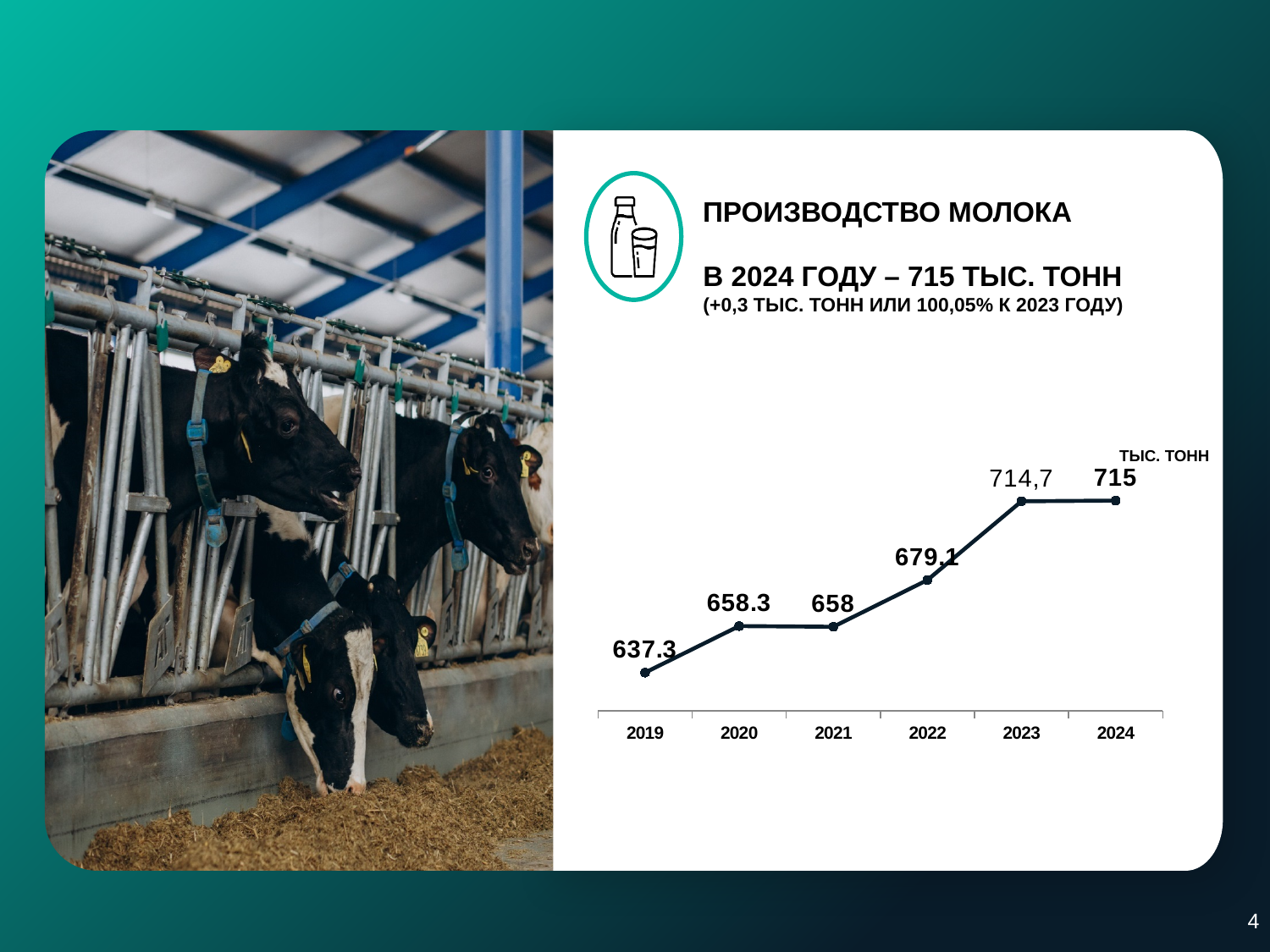
Do the values generally rise or fall from 2019 to 2024? rise Which year has the lowest value? 2019 What is the value for 2023? 714,7 Which year has the highest value? 2024 What type of chart is shown on the slide? line chart What is the value for 2019? 637.3 Which is larger, the value for 2020 or the value for 2021? 2020 What is the difference between the values for 2020 and 2019? 21 What unit is indicated at the top right of the chart? ТЫС. ТОНН What is the value for 2022? 679.1 What is the value for 2024? 715 How many years are plotted on the chart? 6